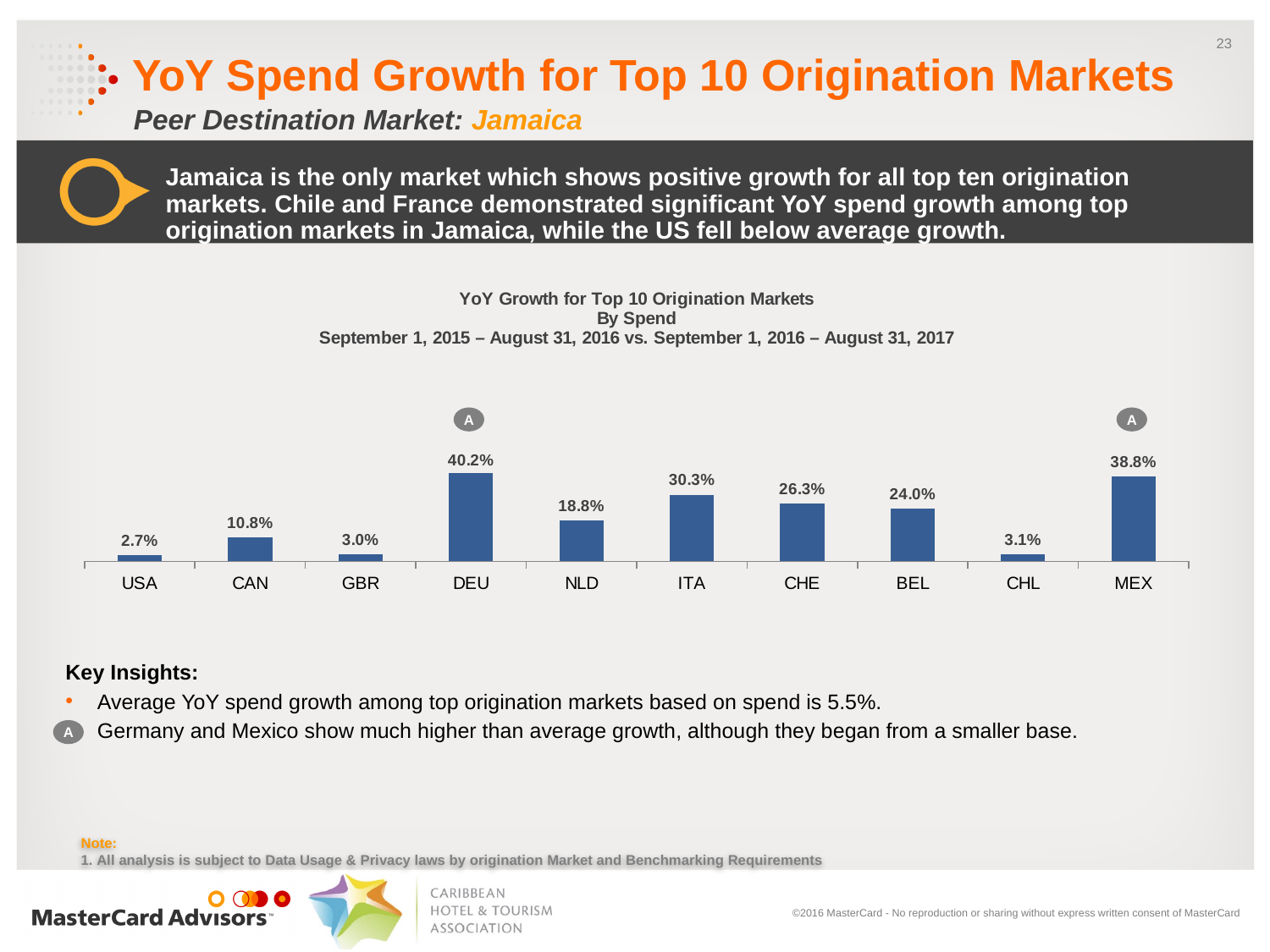
What is the YoY spend growth value for USA? 2.7% Which origination market has the highest YoY spend growth? DEU What is the YoY spend growth value for ITA? 30.3% How many origination markets are shown on the chart? 10 What type of chart is used to show YoY spend growth? Bar chart Which has a higher YoY spend growth, GBR or CHL? CHL What is the difference between the YoY spend growth for CHE and BEL? 2.3% Which origination market has the lowest YoY spend growth? USA What is the YoY spend growth value for DEU? 40.2% What is the title of the chart? YoY Growth for Top 10 Origination Markets By Spend Which has a higher YoY spend growth, CAN or NLD? NLD What is the difference between the YoY spend growth for DEU and MEX? 1.4%